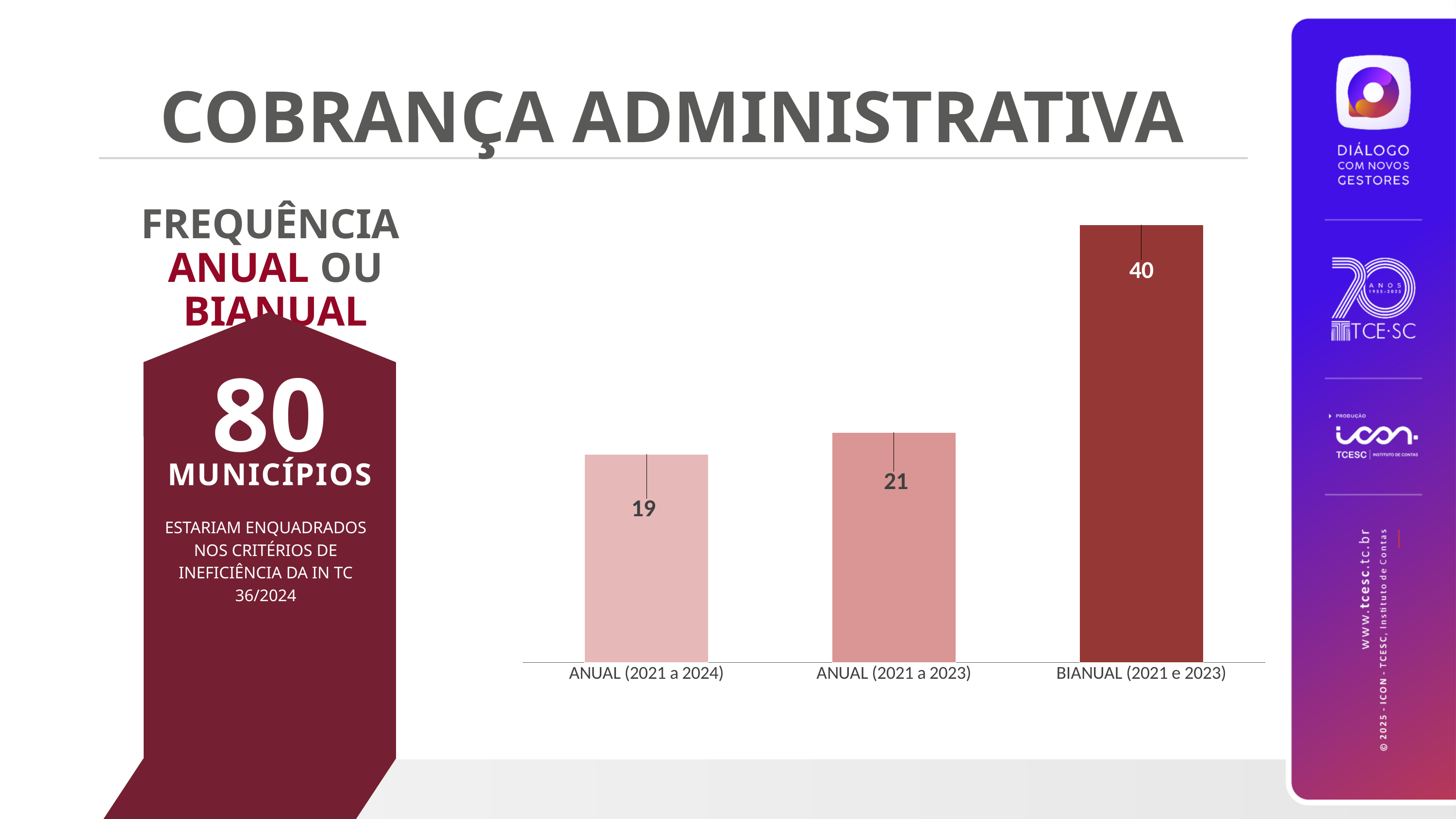
Do the values rise or fall from left to right across the categories? rise Which category has the lowest value? ANUAL (2021 a 2024) What is the total of the three bar values in the chart? 80 What kind of chart is shown on the slide? bar chart How many categories are shown in the chart? 3 What is the difference between the values for ANUAL (2021 a 2023) and ANUAL (2021 a 2024)? 2 What is the value for ANUAL (2021 a 2023)? 21 What is the value for BIANUAL (2021 e 2023)? 40 What is the value for ANUAL (2021 a 2024)? 19 Which category has the highest value? BIANUAL (2021 e 2023) Which is larger, the value for BIANUAL (2021 e 2023) or ANUAL (2021 a 2024)? BIANUAL (2021 e 2023) What is the difference between the values for BIANUAL (2021 e 2023) and ANUAL (2021 a 2023)? 19